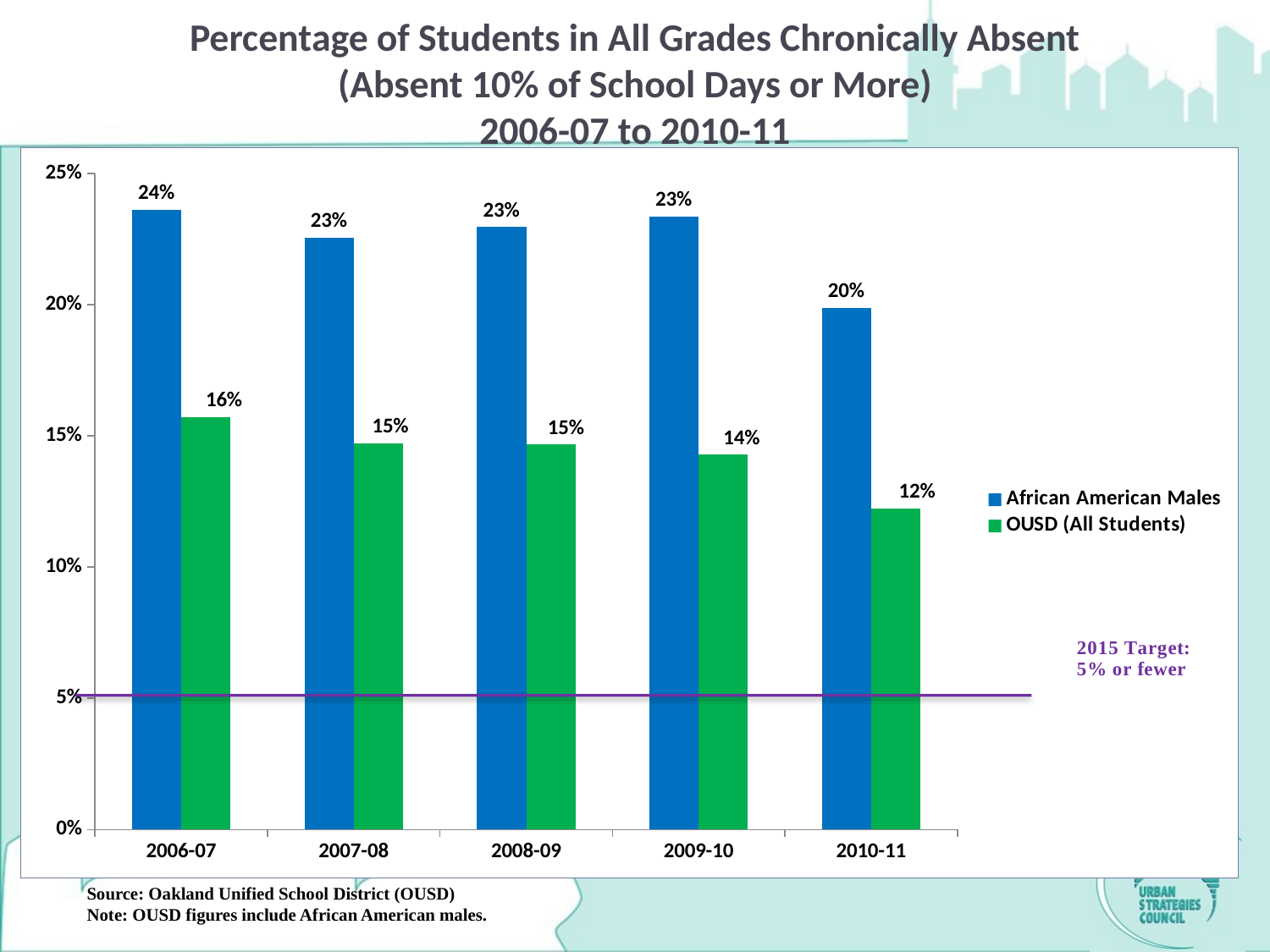
How many series does the legend list? 2 In which school year is the OUSD (All Students) value highest? 2006-07 What is the difference between the African American Males and OUSD (All Students) values in 2010-11? 8% What is the OUSD (All Students) value for 2010-11? 12% What is the 2015 target shown on the chart? 5% or fewer In which school year is the African American Males value lowest? 2010-11 Is the African American Males value for 2010-11 greater or less than 15%? greater What percentage of African American Males were chronically absent in 2006-07? 24% Which is larger in 2008-09: the African American Males value or the OUSD (All Students) value? African American Males How many school years are shown on the x axis? 5 What kind of chart is shown on the slide? Bar chart What is the OUSD (All Students) value for 2009-10? 14%